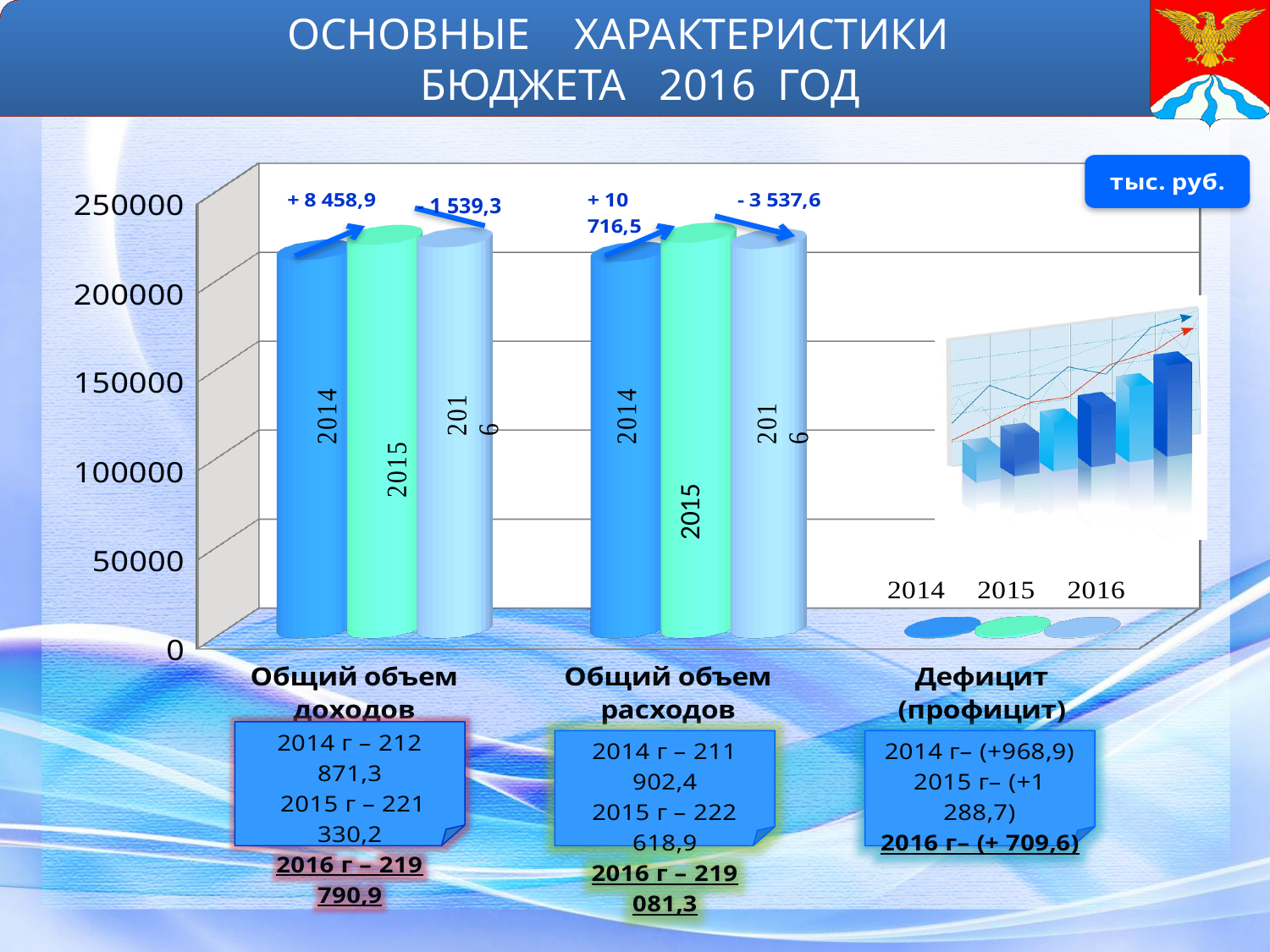
Which is larger in 2015: Общий объем доходов or Общий объем расходов? Общий объем расходов By how much did Общий объем расходов change from 2015 to 2016? - 3 537,6 Which year has the highest Общий объем доходов? 2015 What is the value of Общий объем доходов for 2014? 212 871,3 Which year has the lowest Общий объем расходов? 2014 By how much did Общий объем доходов change from 2014 to 2015? + 8 458,9 How many series does the legend list? 3 What unit of measurement is shown for the chart? тыс. руб. What is the value of Общий объем доходов for 2015? 221 330,2 What is the value of Общий объем расходов for 2014? 211 902,4 Is the value for Общий объем доходов in 2016 greater or less than 200000? greater What is the value of Общий объем расходов for 2016? 219 081,3